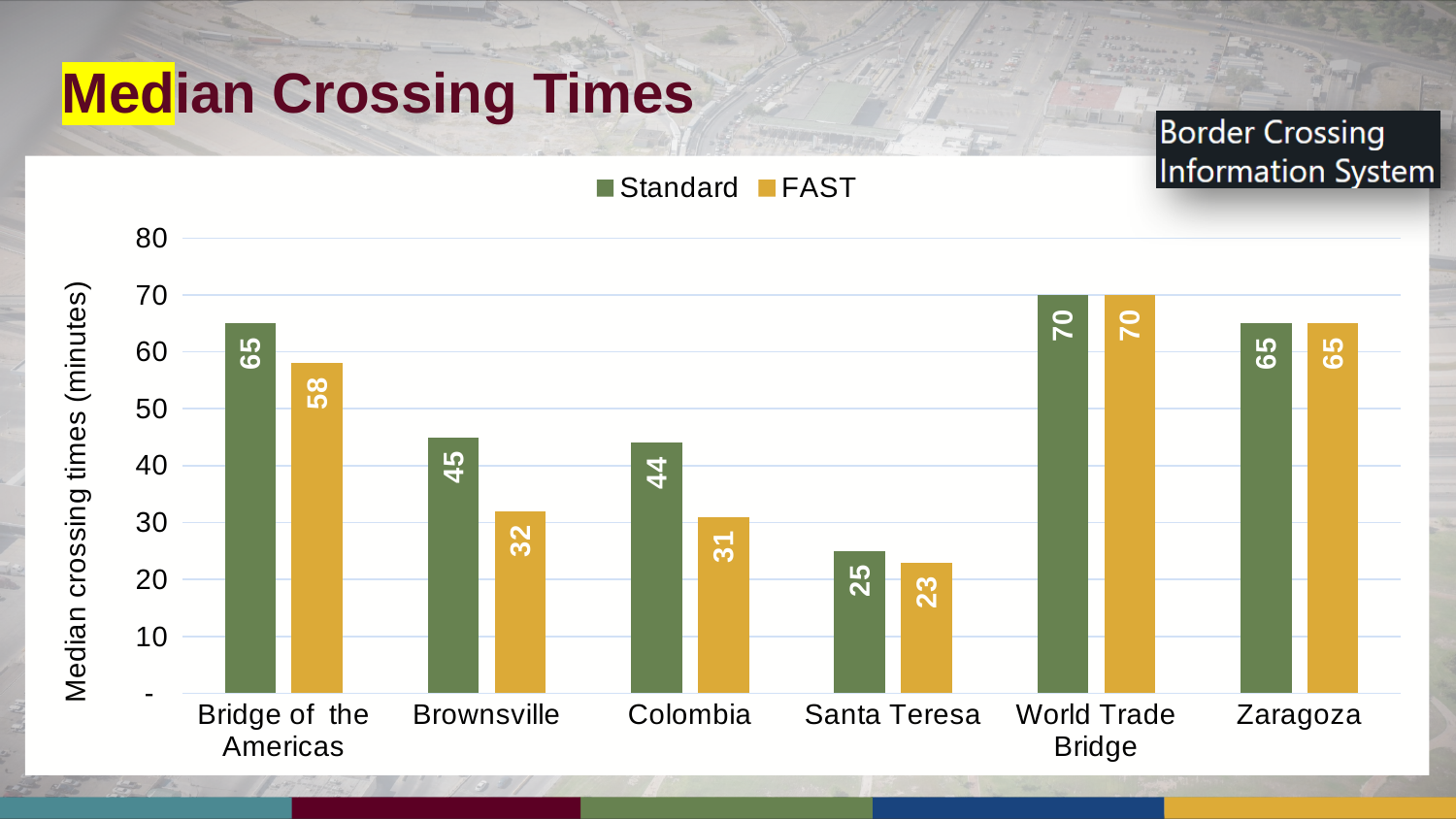
What is the title of the chart? Median Crossing Times Which is larger, the Standard median crossing time at Colombia or at Santa Teresa? Colombia Which crossing has the highest Standard median crossing time? World Trade Bridge What is the Standard median crossing time for Brownsville? 45 What kind of chart is shown on the slide? Bar chart What is the difference between the Standard and FAST median crossing times at Brownsville? 13 How many series does the legend list? 2 How many border crossings are shown on the x axis? 6 What is the FAST median crossing time for Bridge of the Americas? 58 Which crossing has the lowest FAST median crossing time? Santa Teresa What is the FAST median crossing time for Colombia? 31 Is the FAST median crossing time for Zaragoza greater or less than 60? greater